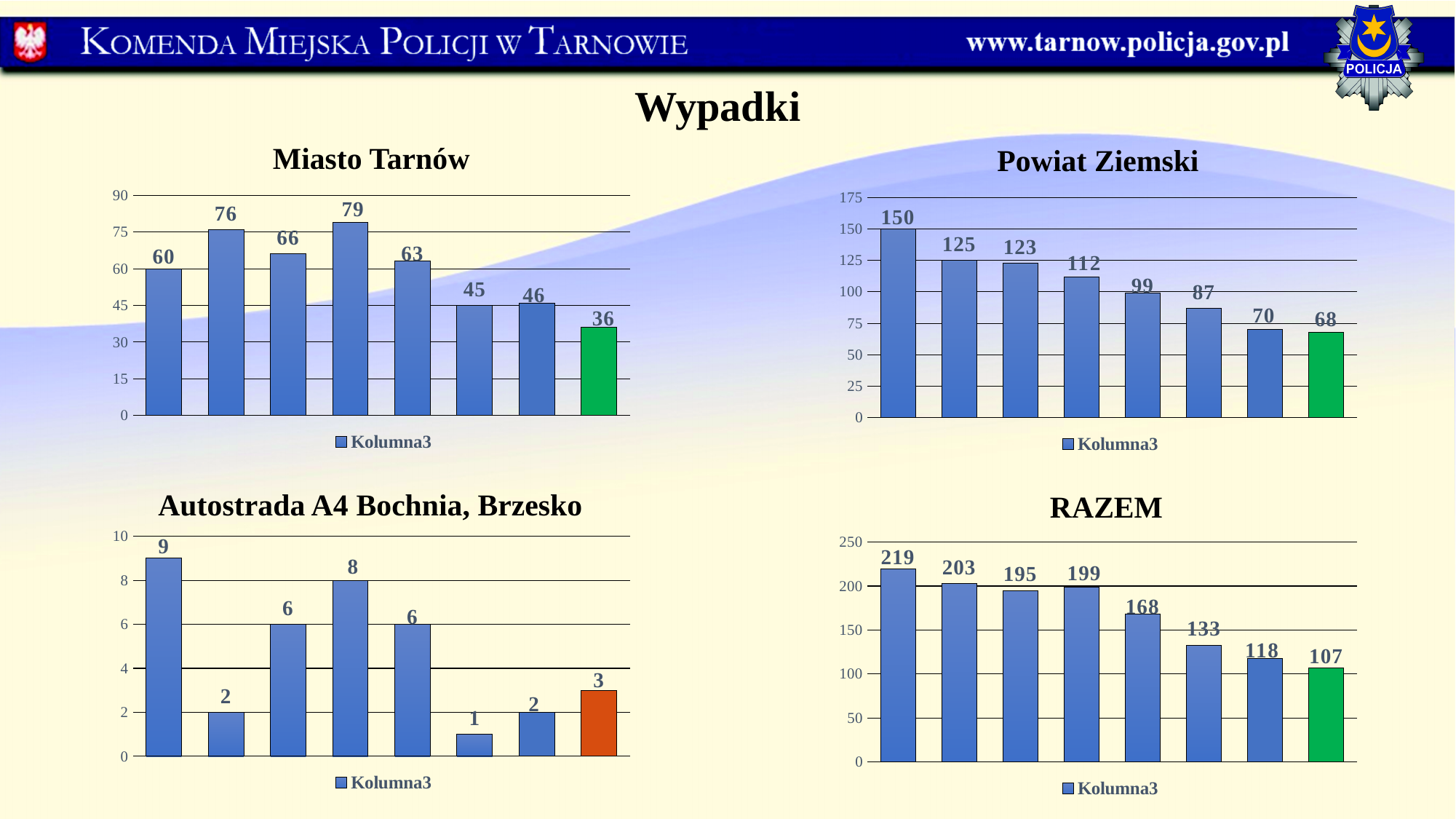
In the 'Powiat Ziemski' chart, what is the difference between the first bar (150) and the last bar (68)? 82 In the 'Autostrada A4 Bochnia, Brzesko' chart, what is the value of the orange bar? 3 What type of chart is 'Powiat Ziemski'? Bar chart In the 'RAZEM' chart, what is the value of the first (leftmost) bar? 219 In the 'Miasto Tarnów' chart, what is the highest value shown? 79 In the 'Powiat Ziemski' chart, what is the lowest value shown? 68 In the 'RAZEM' chart, do the values generally rise or fall from left to right? Fall In the 'Miasto Tarnów' chart, what is the value of the green bar? 36 How many bars does the 'RAZEM' chart contain? 8 In the 'Autostrada A4 Bochnia, Brzesko' chart, what is the highest value shown? 9 In the 'Powiat Ziemski' chart, what is the value of the first (leftmost) bar? 150 In the 'RAZEM' chart, which is larger: the third bar (195) or the fourth bar (199)? 199